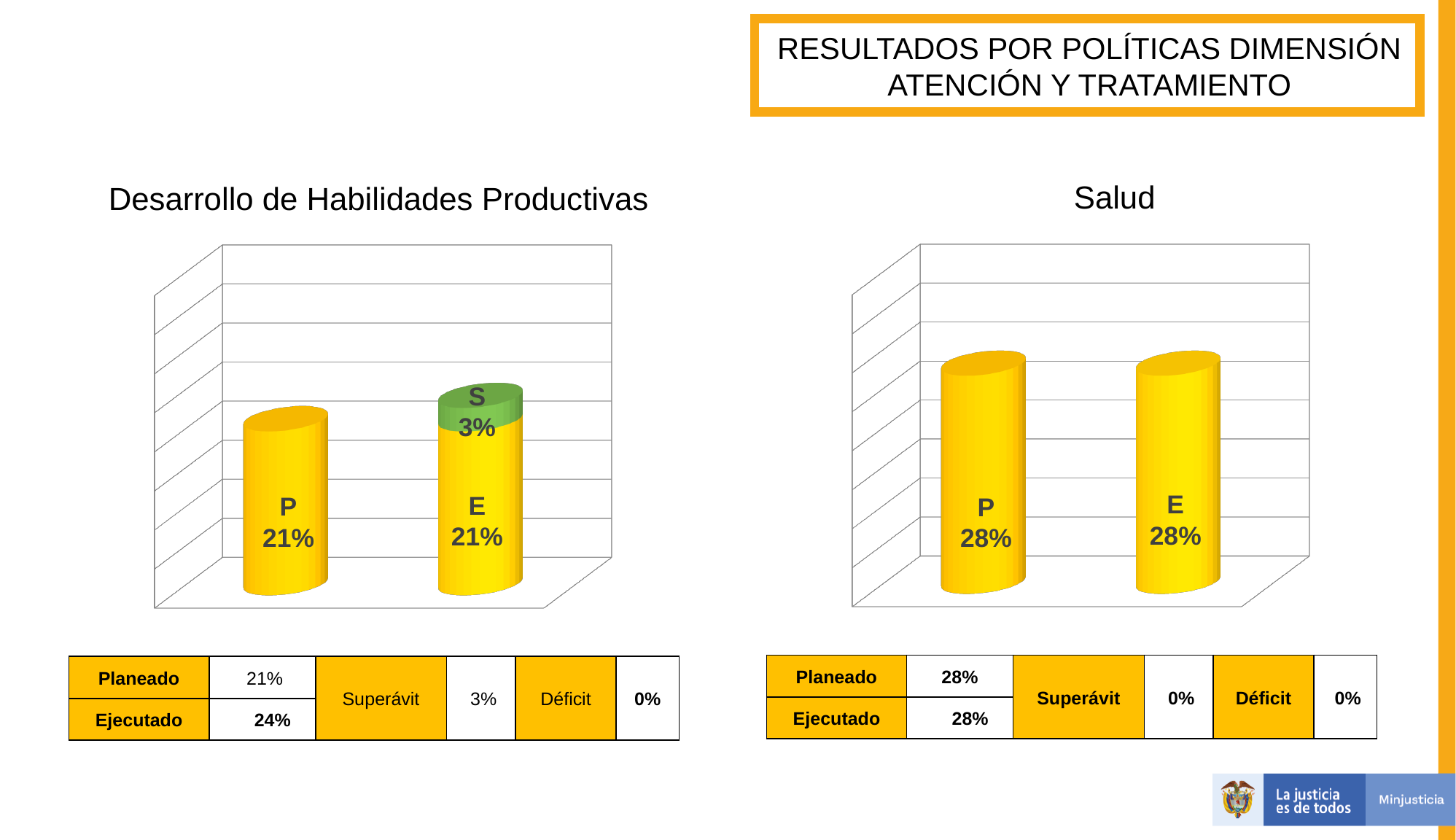
In the 'Salud' chart, how many bars are plotted? 2 In the 'Salud' chart, what is the difference between the P and E values? 0% In the 'Desarrollo de Habilidades Productivas' chart, how many bars are plotted? 2 In the 'Desarrollo de Habilidades Productivas' chart, what is the total of the stacked E bar (E plus S)? 24% What is the title of the chart on the right side of the slide? Salud In the 'Salud' chart, what is the value labelled on the E bar? 28% In the 'Desarrollo de Habilidades Productivas' chart, what value is shown for the green S segment on the E bar? 3% Which chart has the higher P value, 'Desarrollo de Habilidades Productivas' or 'Salud'? Salud In the 'Desarrollo de Habilidades Productivas' chart, what is the value labelled on the P bar? 21% In the 'Desarrollo de Habilidades Productivas' chart, what colour is the S segment on top of the E bar? Green In the 'Desarrollo de Habilidades Productivas' chart, what kind of chart is shown? Bar chart In the 'Salud' chart, what is the value labelled on the P bar? 28%